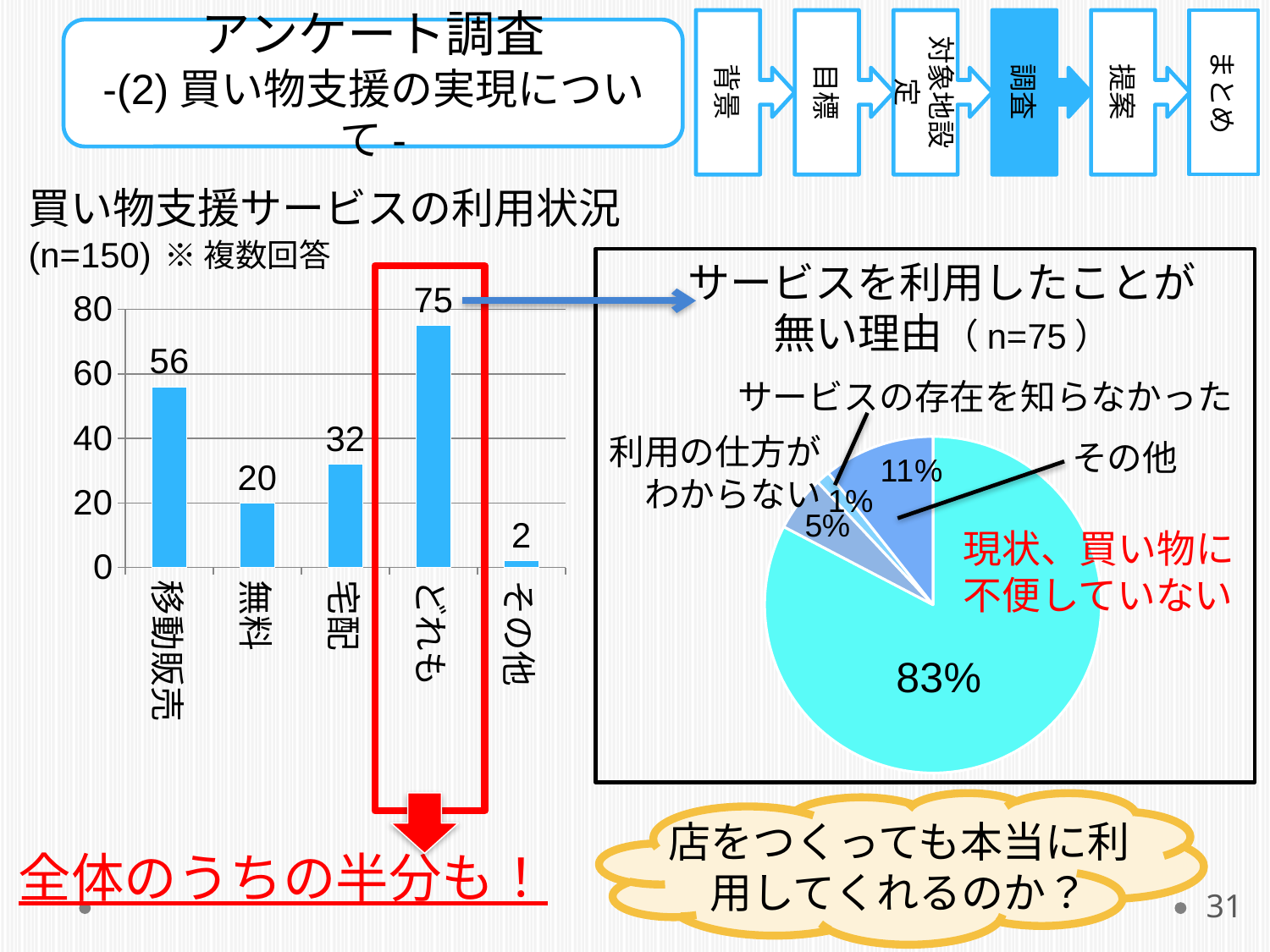
In the bar chart 買い物支援サービスの利用状況, which category has the highest value? どれも In the bar chart 買い物支援サービスの利用状況, what is the value for どれも? 75 In the bar chart 買い物支援サービスの利用状況, what is the difference between the values for どれも and 移動販売? 19 In the bar chart 買い物支援サービスの利用状況, which category has the lowest value? その他 In the bar chart 買い物支援サービスの利用状況, what is the value for 宅配? 32 In the bar chart 買い物支援サービスの利用状況, what is the value for 移動販売? 56 What kind of chart is 買い物支援サービスの利用状況? bar chart In the pie chart サービスを利用したことが無い理由, what share is shown for 現状、買い物に不便していない? 83% In the bar chart 買い物支援サービスの利用状況, which is larger, the value for 宅配 or the value for 無料? 宅配 How many categories are shown in the bar chart 買い物支援サービスの利用状況? 5 In the pie chart サービスを利用したことが無い理由, which slice is the largest? 現状、買い物に不便していない How many slices does the pie chart サービスを利用したことが無い理由 have? 4